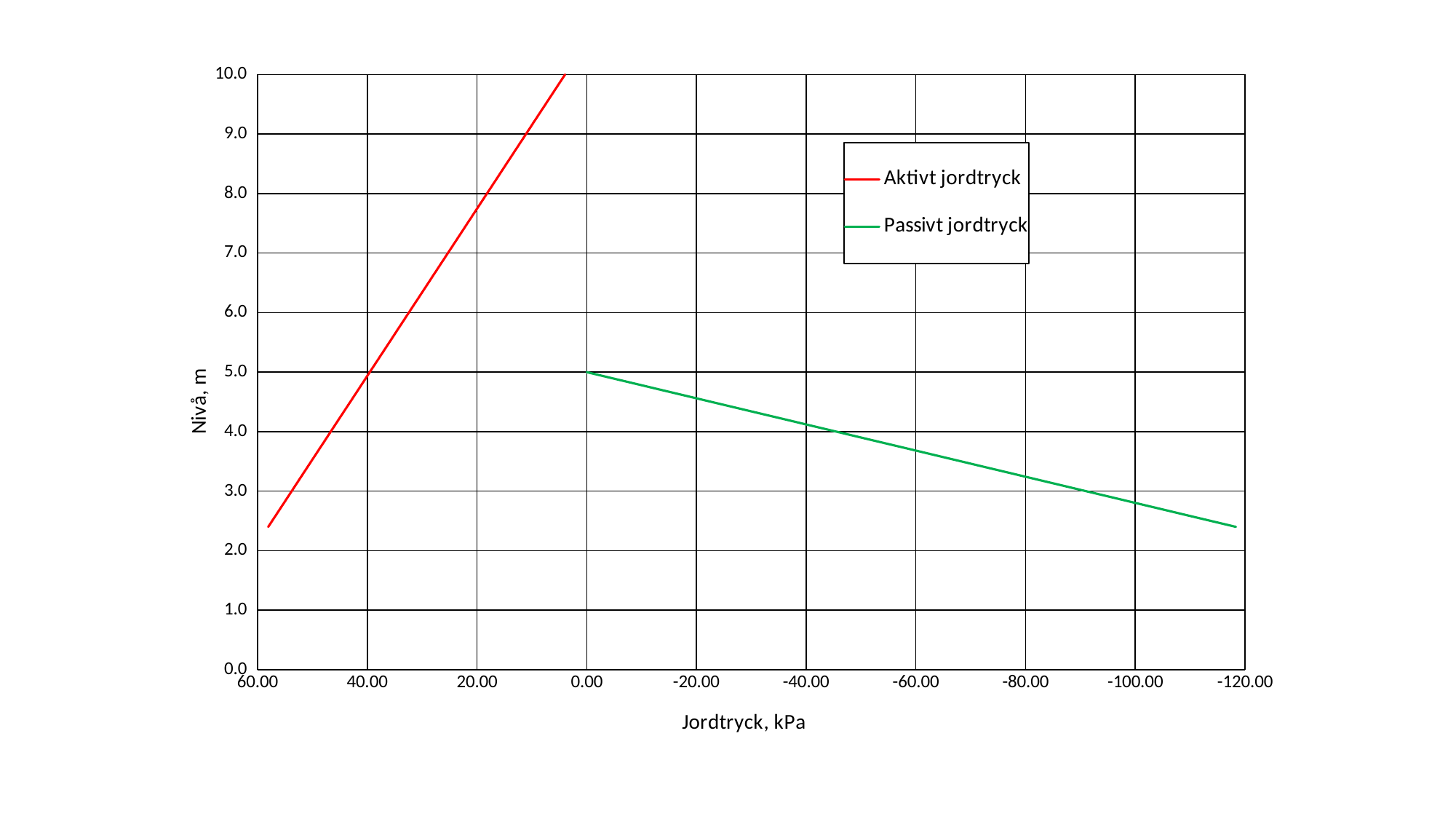
What kind of chart is shown on the slide? line chart What is the title of the horizontal axis? Jordtryck, kPa Does the Nivå of the Aktivt jordtryck line rise or fall as Jordtryck goes from 60.00 toward 0.00? rise How many series does the legend list? 2 What are the two series named in the legend? Aktivt jordtryck and Passivt jordtryck Is the Jordtryck for Passivt jordtryck at Nivå 3.0 m greater or less than -80.00? less Is the Jordtryck for Aktivt jordtryck at Nivå 9.0 m greater or less than 20.00? less Which series reaches the higher Nivå on the chart? Aktivt jordtryck Does the Nivå of the Passivt jordtryck line rise or fall as Jordtryck goes from 0.00 to -120.00? fall At what Nivå does the Passivt jordtryck line begin? 5.0 Is the Jordtryck for Aktivt jordtryck at Nivå 3.0 m greater or less than 40.00? greater At what Jordtryck value does the Passivt jordtryck line begin? 0.00